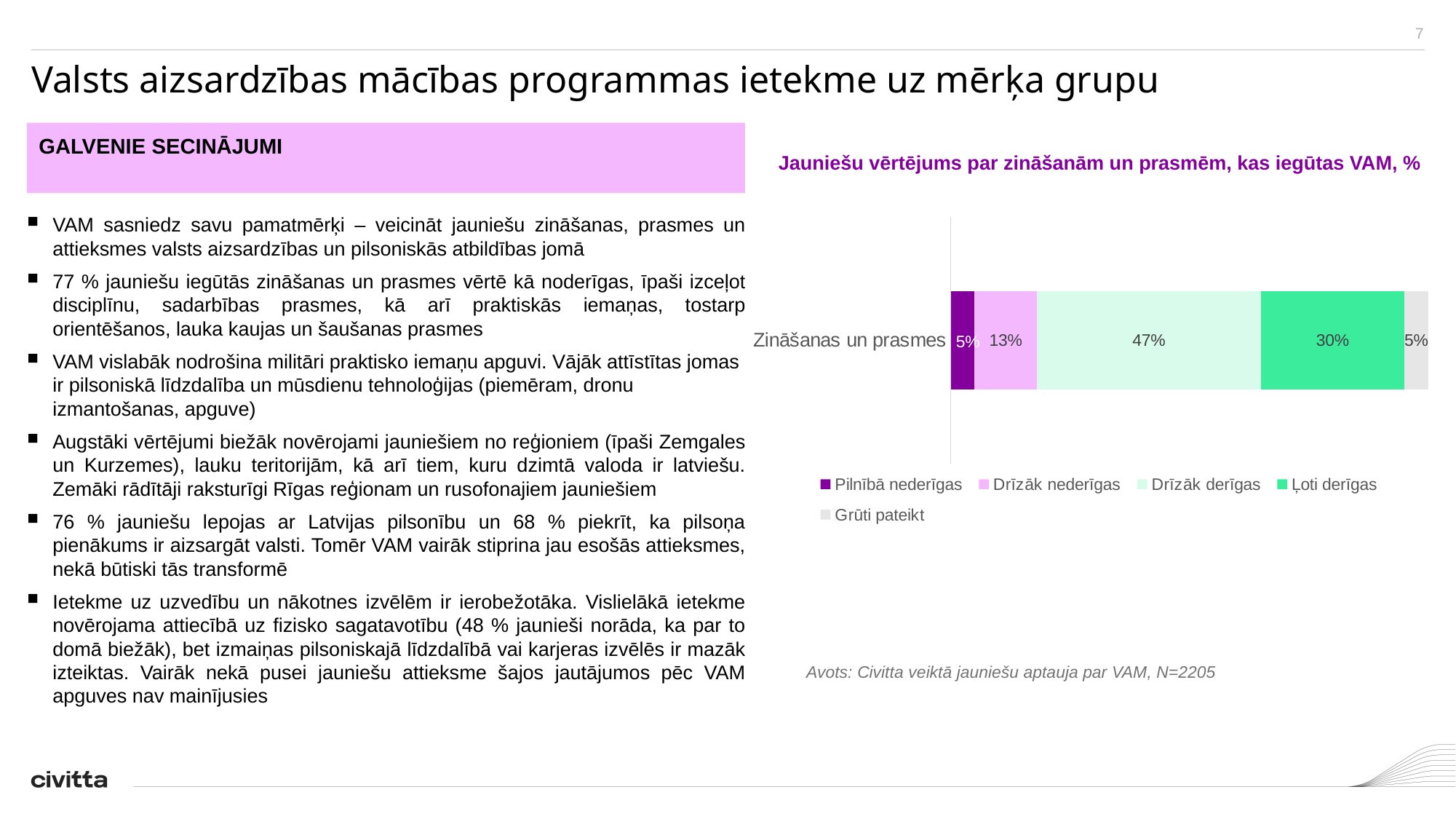
What is the value for the "Drīzāk nederīgas" segment? 13% How many categories are plotted on the chart? 1 What kind of chart is shown on the slide? Stacked bar chart What is the title of the chart? Jauniešu vērtējums par zināšanām un prasmēm, kas iegūtas VAM, % What is the total of all segments in the stacked bar? 100% How many series does the legend list? 5 What is the value for the "Pilnībā nederīgas" segment? 5% What percentage of respondents rated the knowledge and skills as "Drīzāk derīgas"? 47% What is the difference between the "Drīzāk derīgas" and "Ļoti derīgas" values? 17 percentage points Which series has the largest share of the bar? Drīzāk derīgas What is the value for the "Ļoti derīgas" segment of the bar? 30% Which is larger, the "Drīzāk nederīgas" value or the "Ļoti derīgas" value? Ļoti derīgas